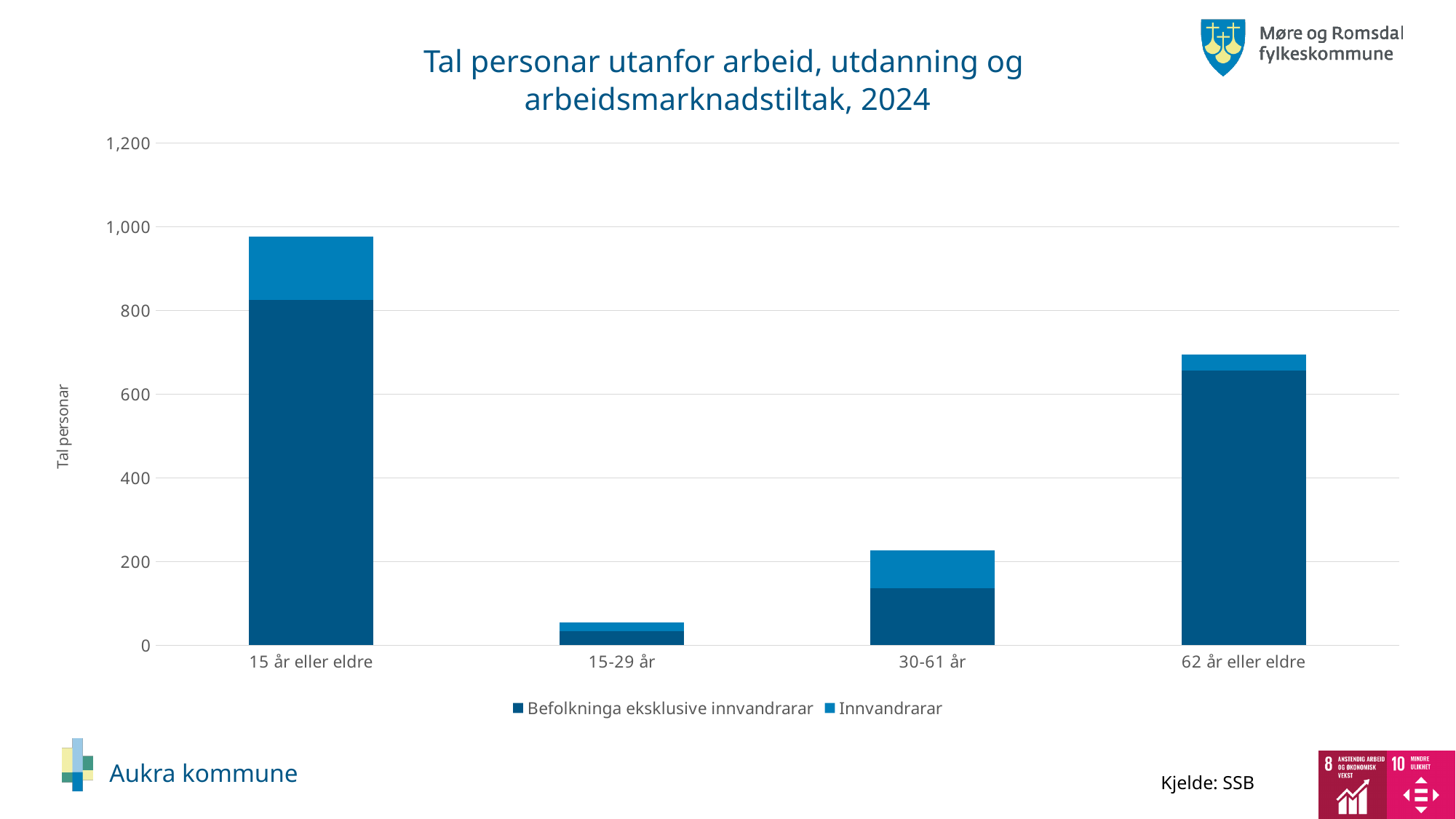
How many age categories are shown on the x axis? 4 Which has a taller stacked bar, 30-61 år or 62 år eller eldre? 62 år eller eldre Is the total stacked bar for 15 år eller eldre greater or less than 800? greater Is the total stacked bar for 30-61 år greater or less than 400? less What is the title of the chart? Tal personar utanfor arbeid, utdanning og arbeidsmarknadstiltak, 2024 What is the label of the y axis? Tal personar Is the total stacked bar for 15-29 år greater or less than 200? less Which category has the tallest stacked bar? 15 år eller eldre What kind of chart is shown on the slide? Stacked bar chart How many series does the legend list? 2 Which category has the shortest stacked bar? 15-29 år